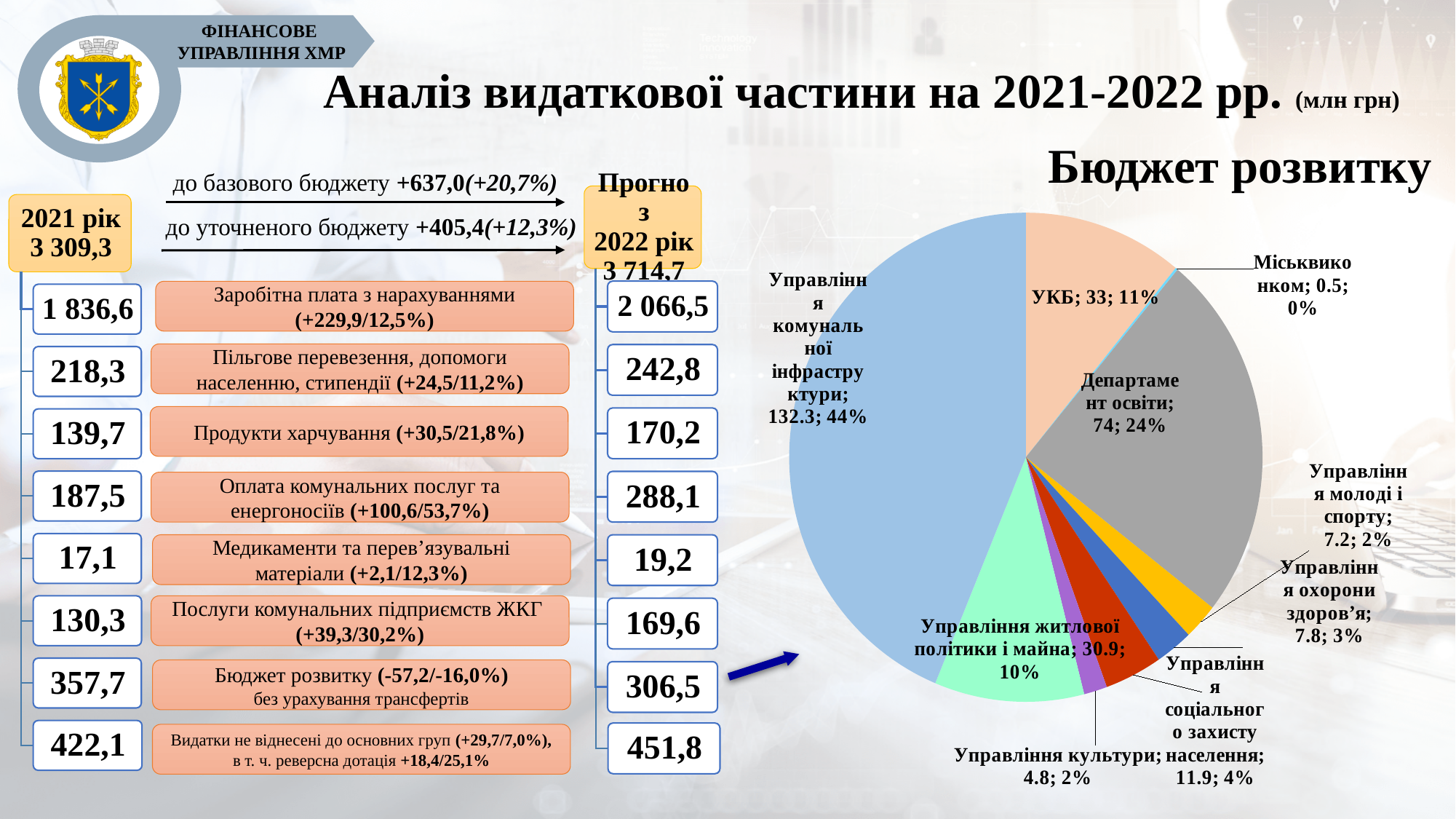
In the "Бюджет розвитку" pie chart, what value is shown for Департамент освіти? 74 In the "Бюджет розвитку" pie chart, what is the difference between the values for Департамент освіти and УКБ? 41 In the "Бюджет розвитку" pie chart, what share does Управління комунальної інфраструктури have? 44% In the "Бюджет розвитку" pie chart, what value is shown for Управління соціального захисту населення? 11.9 In the "Бюджет розвитку" pie chart, which is larger: Управління охорони здоров'я or Управління молоді і спорту? Управління охорони здоров'я In the "Бюджет розвитку" pie chart, which category has the smallest slice? Міськвиконком What is the title of the pie chart on the slide? Бюджет розвитку In the "Бюджет розвитку" pie chart, which category has the largest slice? Управління комунальної інфраструктури What kind of chart is shown under the title "Бюджет розвитку"? pie chart In the "Бюджет розвитку" pie chart, what value is shown for УКБ? 33 How many slices does the "Бюджет розвитку" pie chart have? 9 In the "Бюджет розвитку" pie chart, what share does Управління житлової політики і майна have? 10%